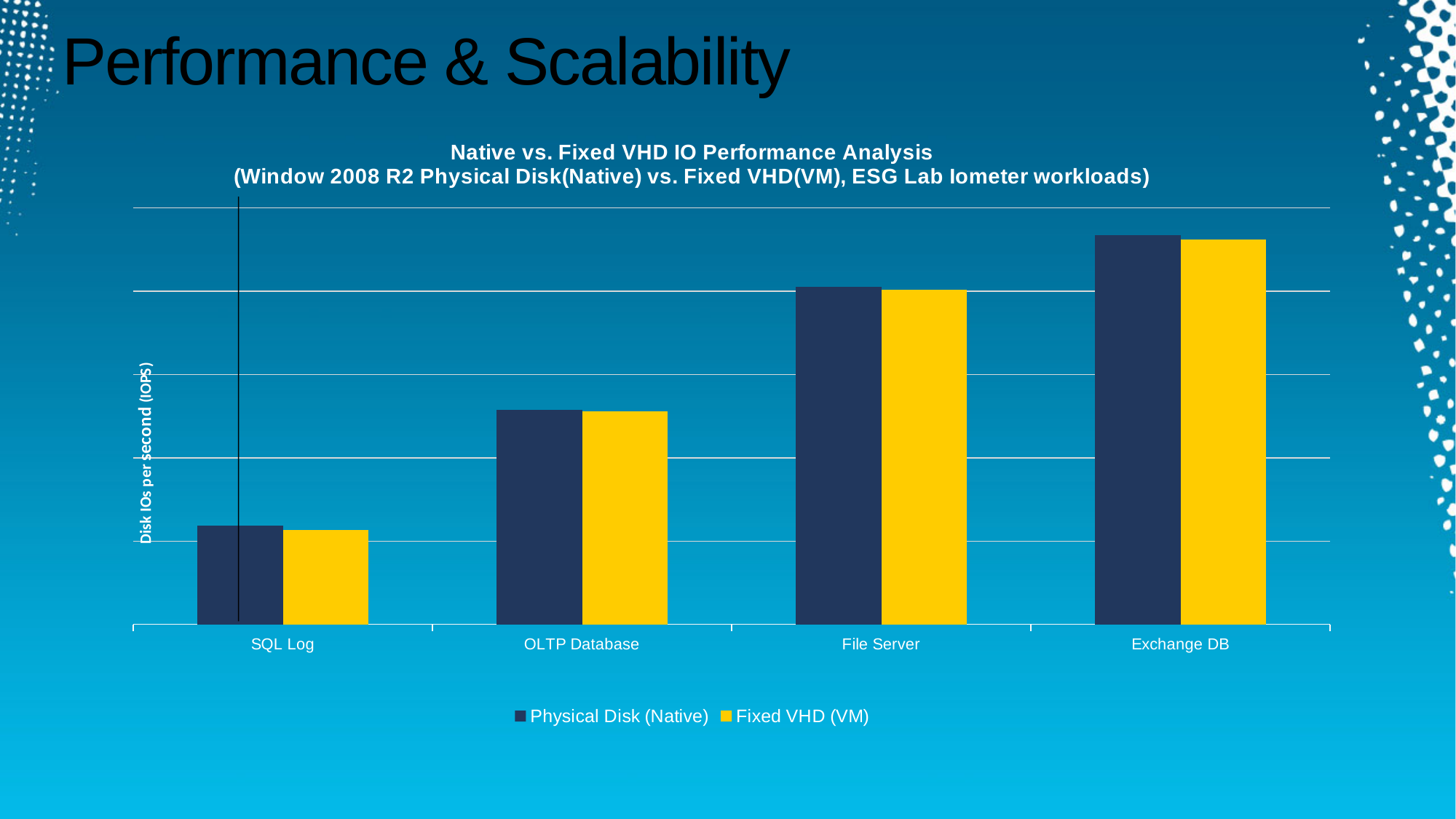
Which workload has the highest Fixed VHD (VM) IOPS? Exchange DB What is the label on the y axis? Disk IOs per second (IOPS) Which workload has the lowest Fixed VHD (VM) IOPS? SQL Log How many series does the legend list? 2 How many workload categories are shown on the x axis? 4 What kind of chart is shown on the slide? bar chart For Fixed VHD (VM), which is larger: SQL Log or Exchange DB? Exchange DB Which workload has the highest Physical Disk (Native) IOPS? Exchange DB Which series is shown in yellow? Fixed VHD (VM) Which workload has the lowest Physical Disk (Native) IOPS? SQL Log For Physical Disk (Native), which is larger: File Server or OLTP Database? File Server Do the IOPS values rise or fall moving from SQL Log to Exchange DB along the x axis? rise